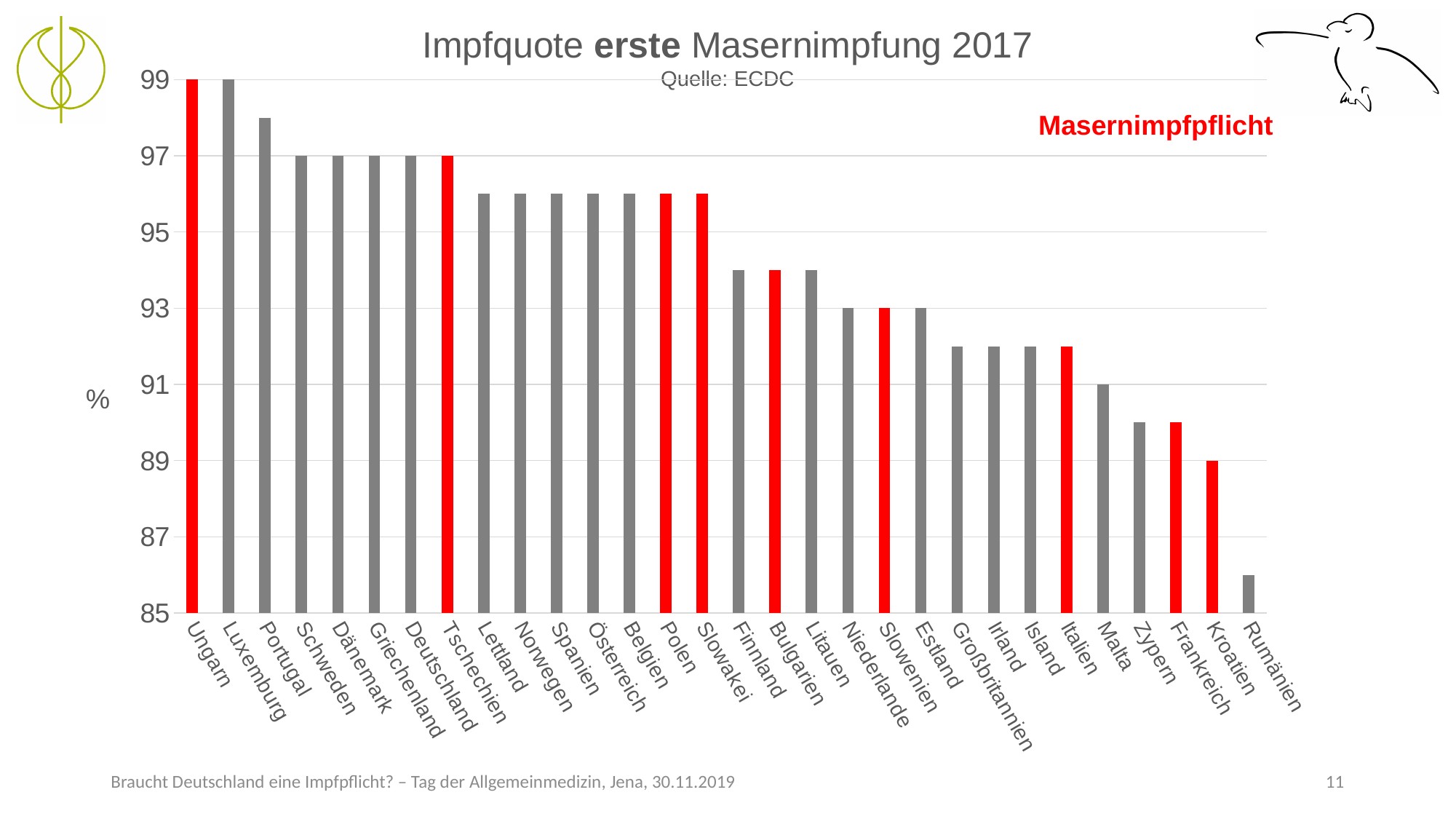
Which country has the lowest value? Rumänien What is the difference between the values for Deutschland and Kroatien? 8 What is the value for Deutschland? 97 Which is larger, the value for Slowenien or the value for Malta? Slowenien What kind of chart is shown on the slide? bar chart What is the value for Ungarn? 99 Do the values rise or fall from left to right along the x axis? fall Is the value for Rumänien greater or less than 87? less Is the value for Polen greater or less than 95? greater What is the value for Malta? 91 How many countries are shown on the x axis? 30 What is the value for Kroatien? 89